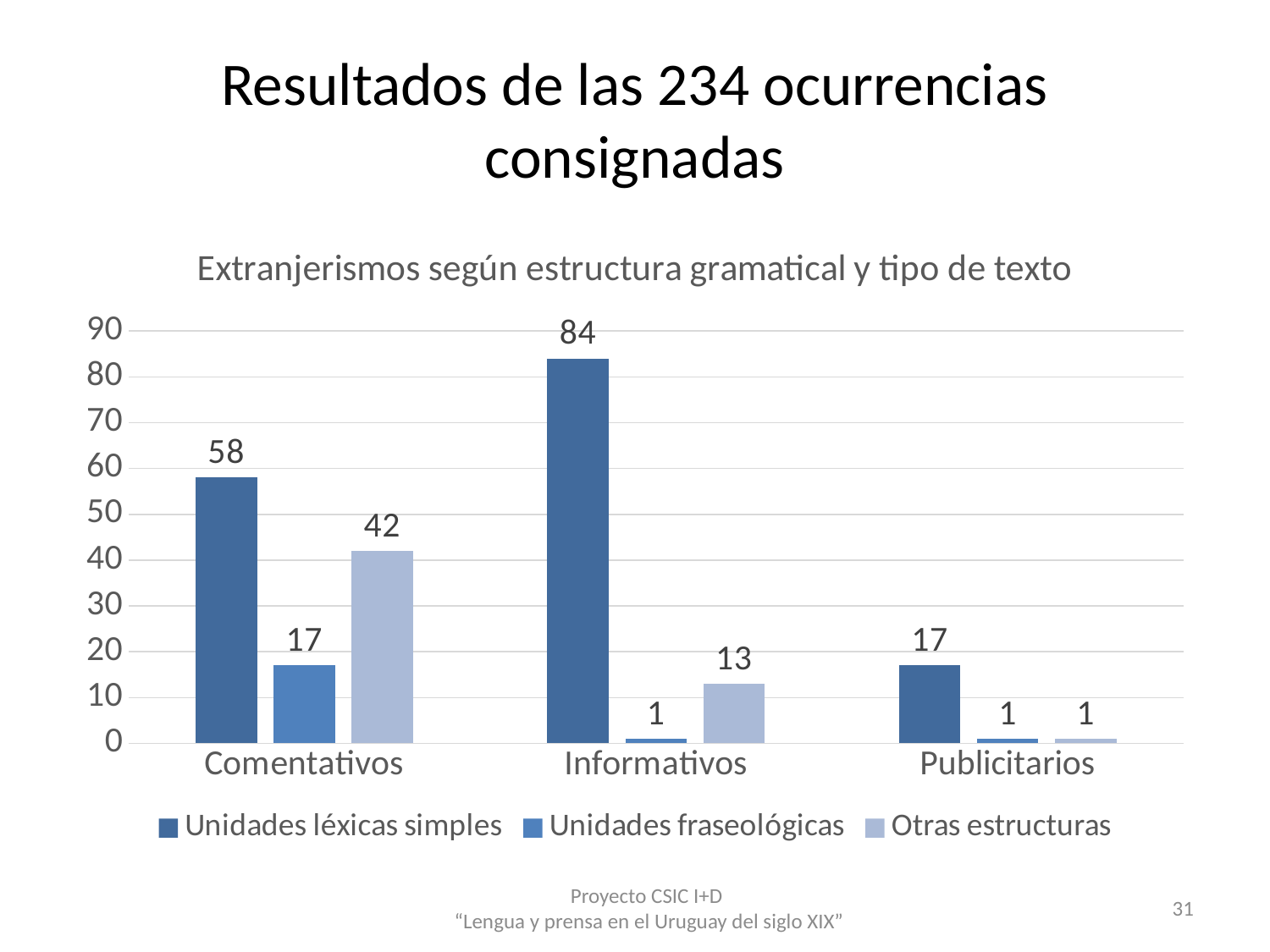
Which category has the highest value for Unidades léxicas simples? Informativos Which category has the lowest value for Otras estructuras? Publicitarios Is the value for Unidades léxicas simples in Comentativos greater or less than 50? greater How many series does the legend list? 3 What is the value for Otras estructuras in the Comentativos category? 42 What kind of chart is shown on the slide? Bar chart What is the title of the chart? Extranjerismos según estructura gramatical y tipo de texto What is the difference between Unidades léxicas simples in Informativos and in Comentativos? 26 Which is larger: Otras estructuras in Comentativos or Unidades léxicas simples in Publicitarios? Otras estructuras in Comentativos What is the value for Unidades léxicas simples in the Informativos category? 84 How many categories are shown on the x axis? 3 What is the value for Unidades fraseológicas in the Publicitarios category? 1